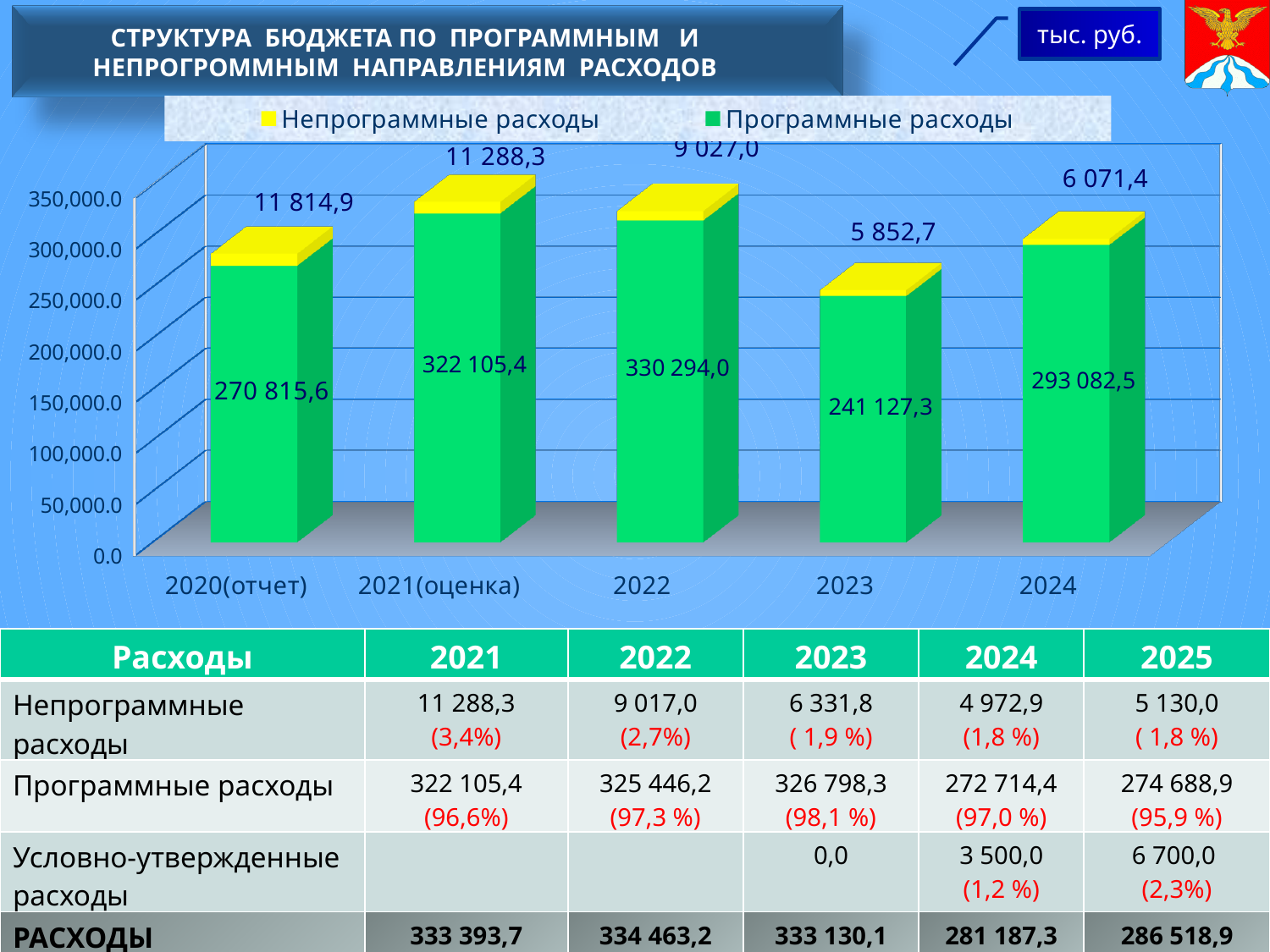
What is the value of Программные расходы for 2020(отчет)? 270 815,6 Which colour represents Непрограммные расходы in the chart? yellow What is the value of Программные расходы for 2024? 293 082,5 What type of chart is shown on the slide? bar chart How many categories are shown along the x axis of the chart? 5 What is the difference between Программные расходы in 2022 and in 2021(оценка)? 8 188,6 What is the total of the stacked bar for 2023? 246 980,0 In which year are Непрограммные расходы the lowest? 2023 Which is larger: Программные расходы in 2021(оценка) or in 2024? 2021(оценка) What is the value of Непрограммные расходы for 2023? 5 852,7 How many series does the chart legend list? 2